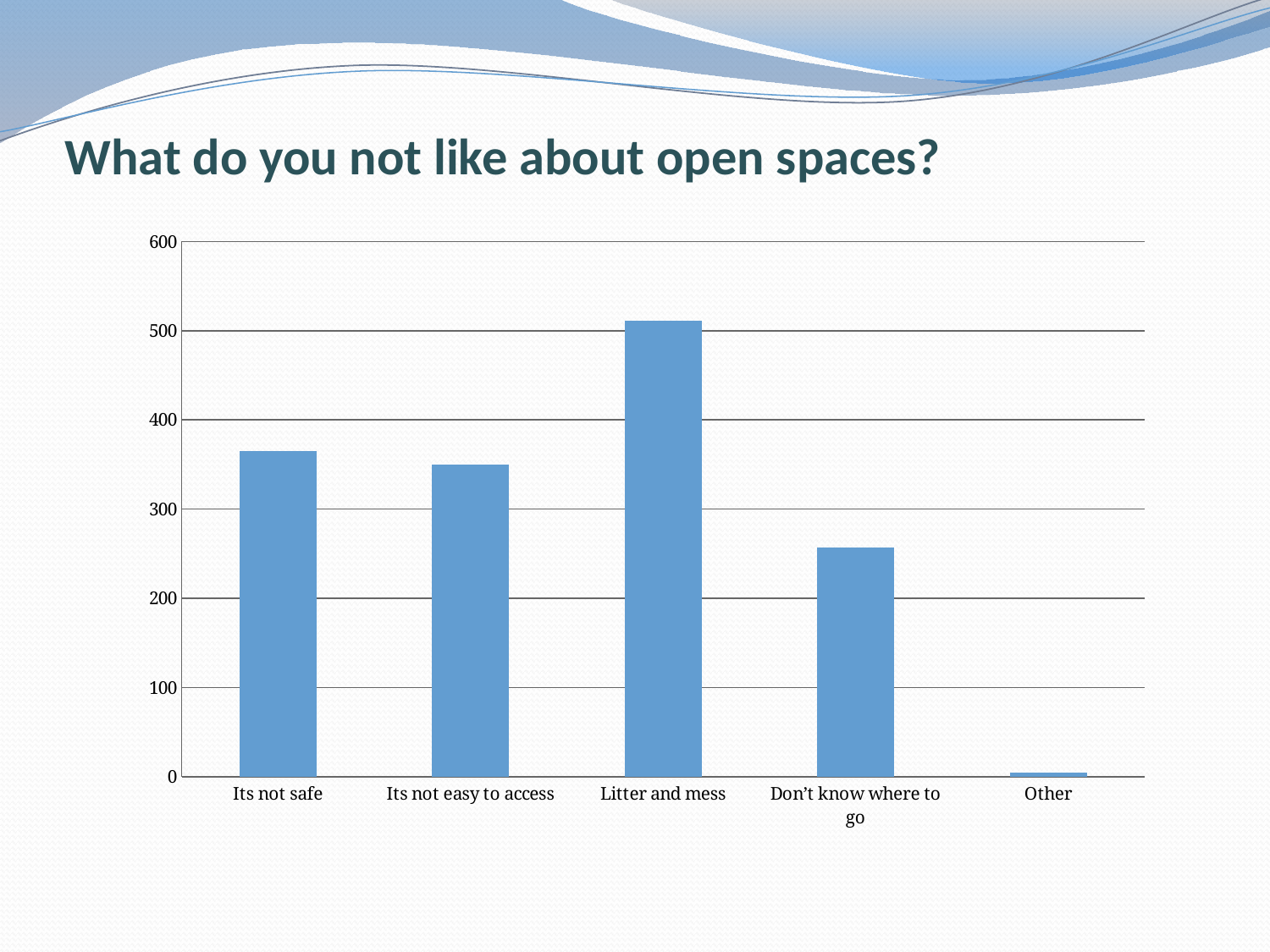
How many categories are shown on the x axis of the chart? 5 What is the title of the slide containing the chart? What do you not like about open spaces? Which is larger, the value for Its not safe or the value for Don't know where to go? Its not safe Is the value for Its not easy to access greater or less than 300? greater Is the value for Litter and mess greater or less than 500? greater Which category has the highest value in the chart? Litter and mess What kind of chart is shown on the slide? bar chart Which is larger, the value for Litter and mess or the value for Don't know where to go? Litter and mess Is the value for Its not safe greater or less than 400? less Which category has the lowest value in the chart? Other